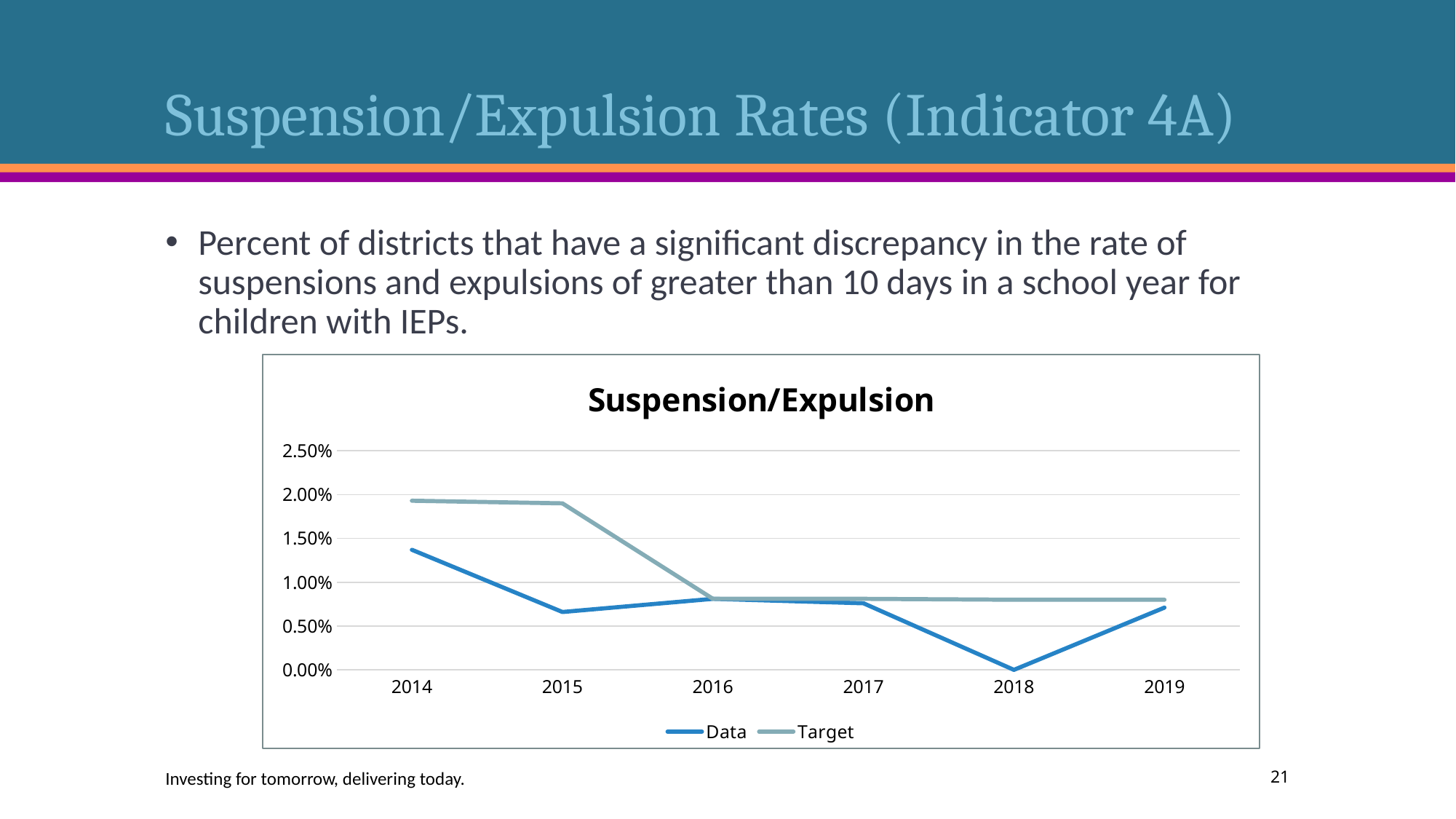
In 2015, which is larger, the Data value or the Target value? Target What is the Data value for 2018? 0.00% How many series does the chart's legend list? 2 Is the Data value for 2014 greater or less than 1.00%? greater How many years are plotted along the x axis of the chart? 6 Is the Target value for 2016 greater or less than 1.00%? less In which year is the Data series at its lowest? 2018 Is the Target value for 2014 greater or less than 1.50%? greater Does the Target series rise or fall from 2014 to 2019? Fall What kind of chart is shown on the slide? Line chart What is the title of the chart? Suspension/Expulsion In which year is the Data series at its highest? 2014